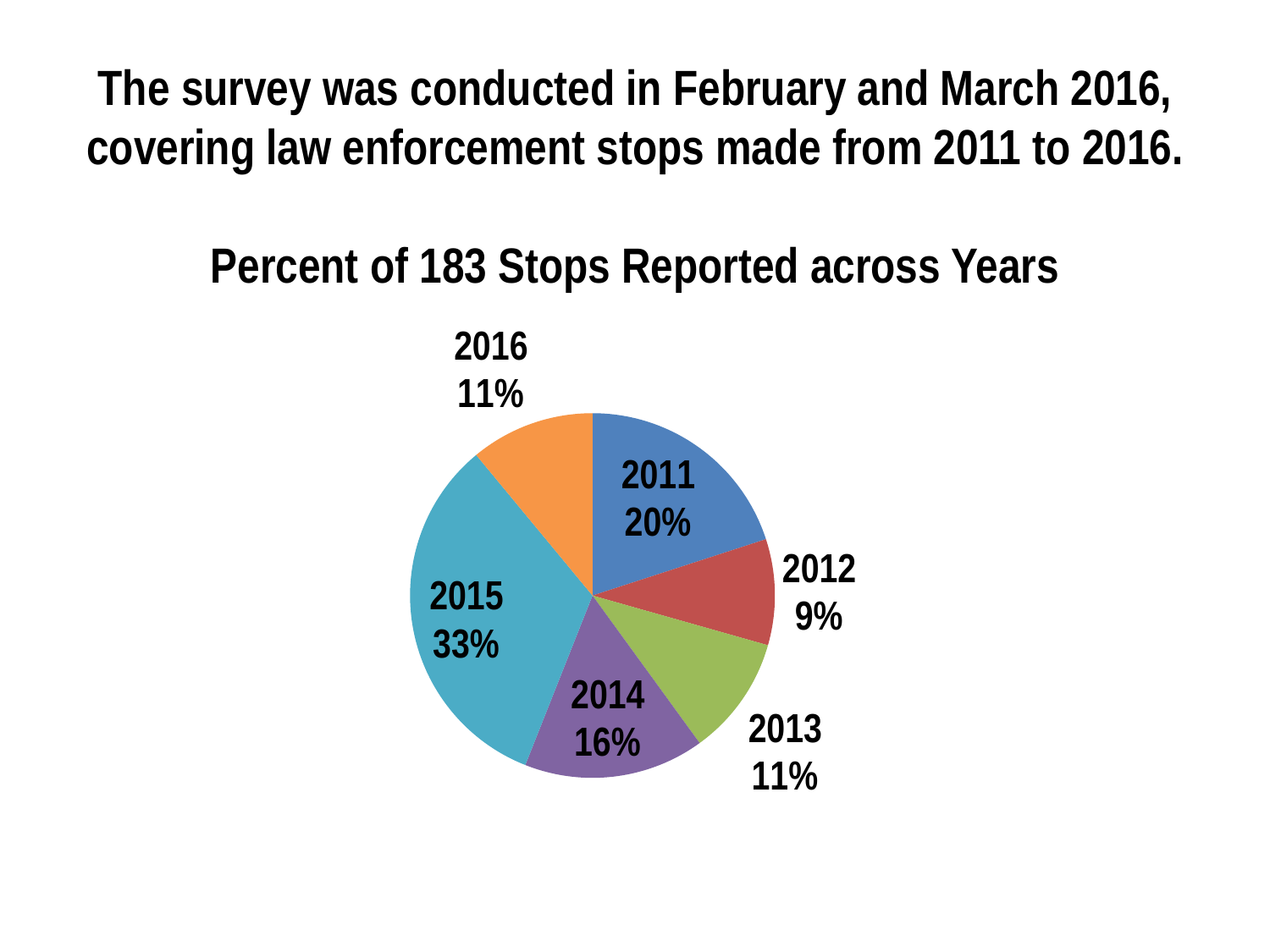
Which year has the largest share of stops? 2015 What is the difference in percentage points between 2015 and 2011? 13 How many years (slices) are shown in the pie chart? 6 What type of chart is shown on the slide? pie chart What colour is the slice for 2015? teal (light blue) What percentage of stops were reported in 2012? 9% What percentage of stops were reported in 2014? 16% What is the title of the chart? Percent of 183 Stops Reported across Years What percentage of stops were reported in 2011? 20% Which year has a larger share of stops, 2014 or 2012? 2014 What percentage of stops were reported in 2015? 33% Which year has the smallest share of stops? 2012